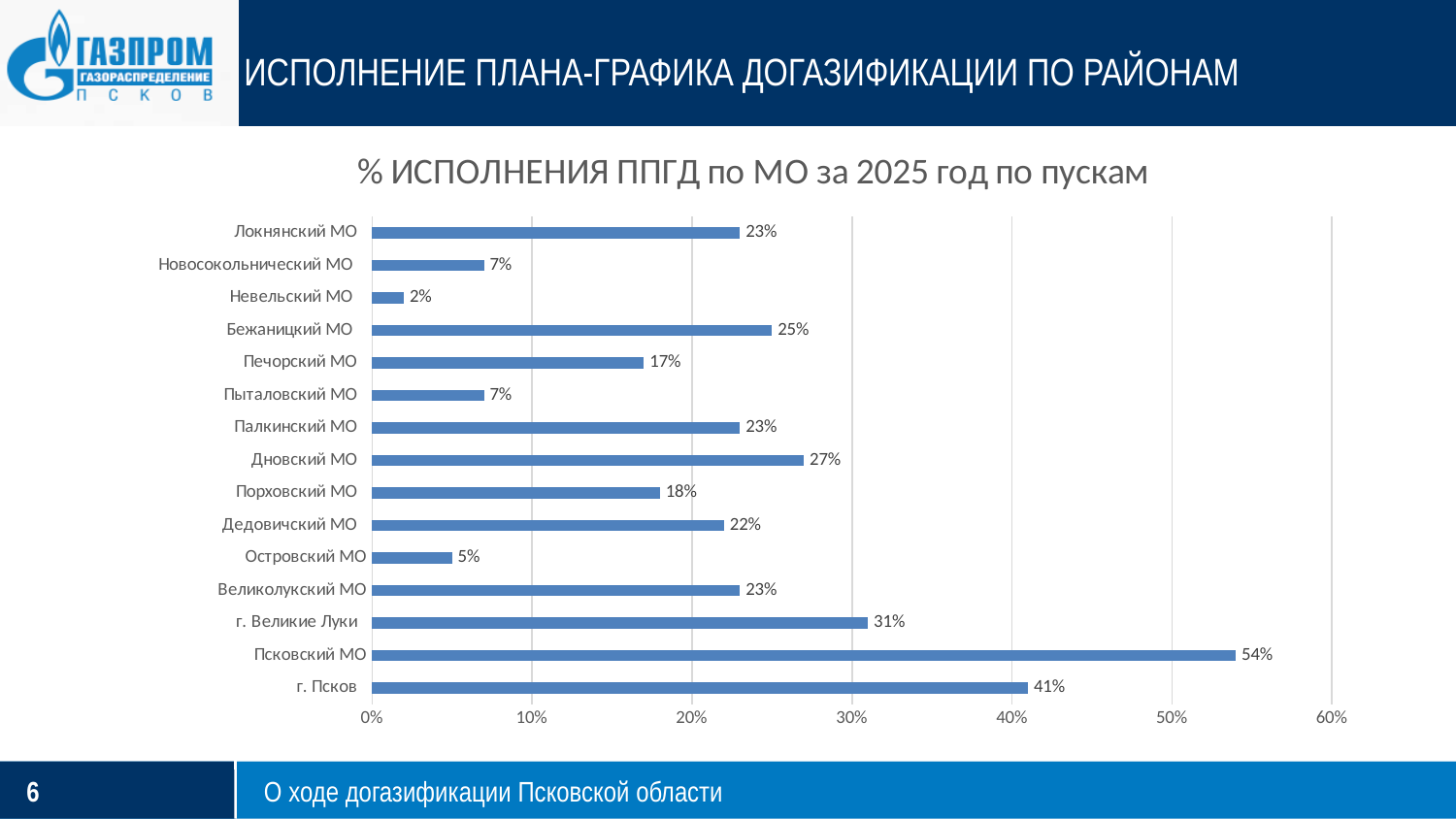
What kind of chart is shown on the slide? Bar chart What is the value for Печорский МО? 17% What is the difference between the values for Дедовичский МО and Островский МО? 17% Which category has the lowest value? Невельский МО Is the value for г. Псков greater or less than 40%? greater How many categories are shown on the chart? 15 What is the value for г. Великие Луки? 31% What is the value for Псковский МО? 54% Which category has the highest value? Псковский МО Which is larger, the value for Дновский МО or the value for Бежаницкий МО? Дновский МО What is the difference between the values for Псковский МО and г. Псков? 13% What is the title of the chart? % ИСПОЛНЕНИЯ ППГД по МО за 2025 год по пускам